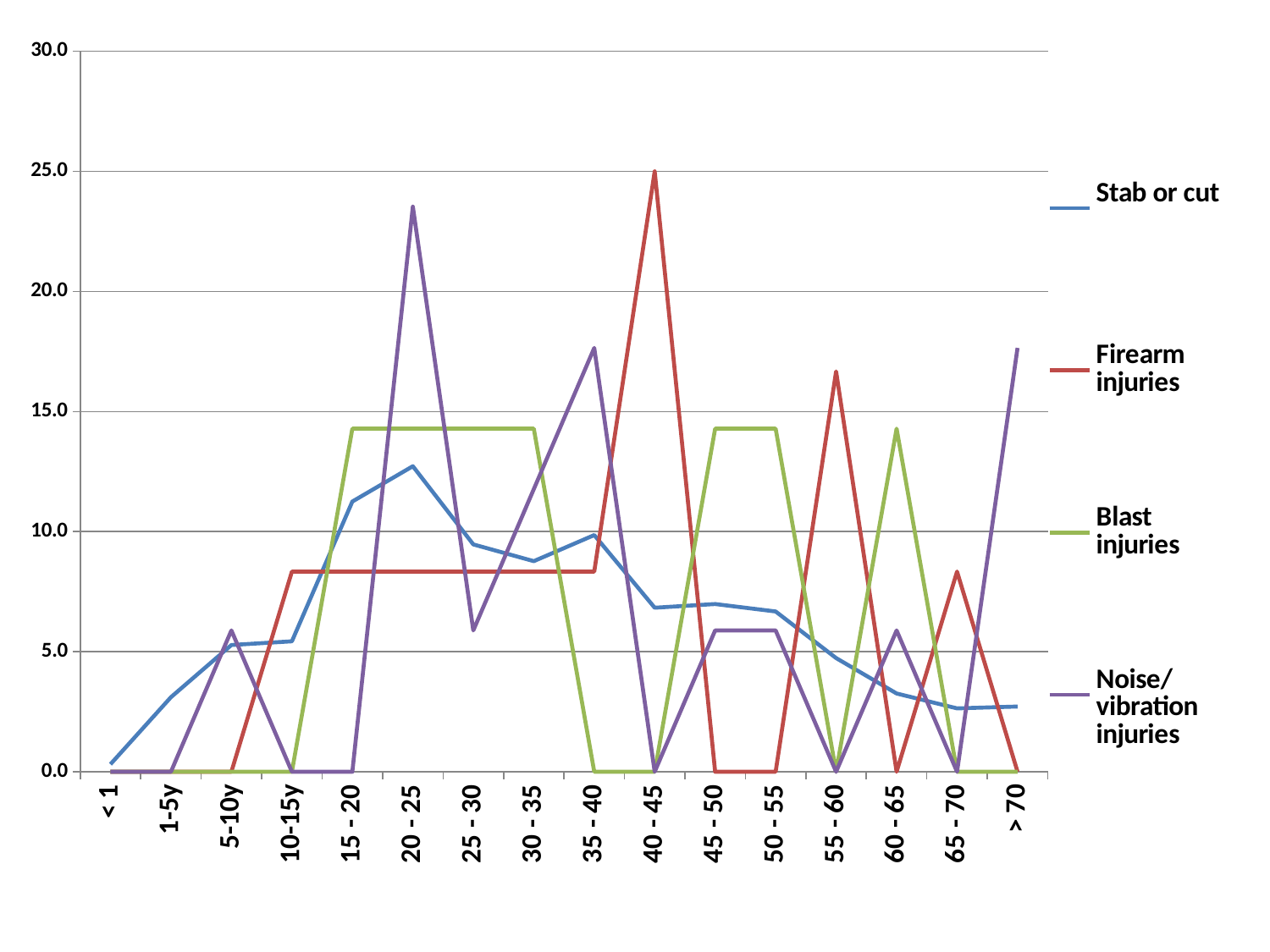
What is the value for Blast injuries in the < 1 age group? 0.0 Is the value for Stab or cut in the 20 - 25 age group greater or less than 10.0? greater In the 40 - 45 age group, which is larger: Firearm injuries or Stab or cut? Firearm injuries How many series does the legend list? 4 What kind of chart is shown on the slide? line chart In which age group do Firearm injuries reach their highest value? 40 - 45 Is the value for Blast injuries in the 15 - 20 age group greater or less than 10.0? greater What colour is the line for Blast injuries? green How many age categories are shown along the x axis? 16 In which age group do Noise/vibration injuries reach their highest value? 20 - 25 Is the value for Noise/vibration injuries in the 20 - 25 age group greater or less than 20.0? greater What is the value for Firearm injuries in the 40 - 45 age group? 25.0